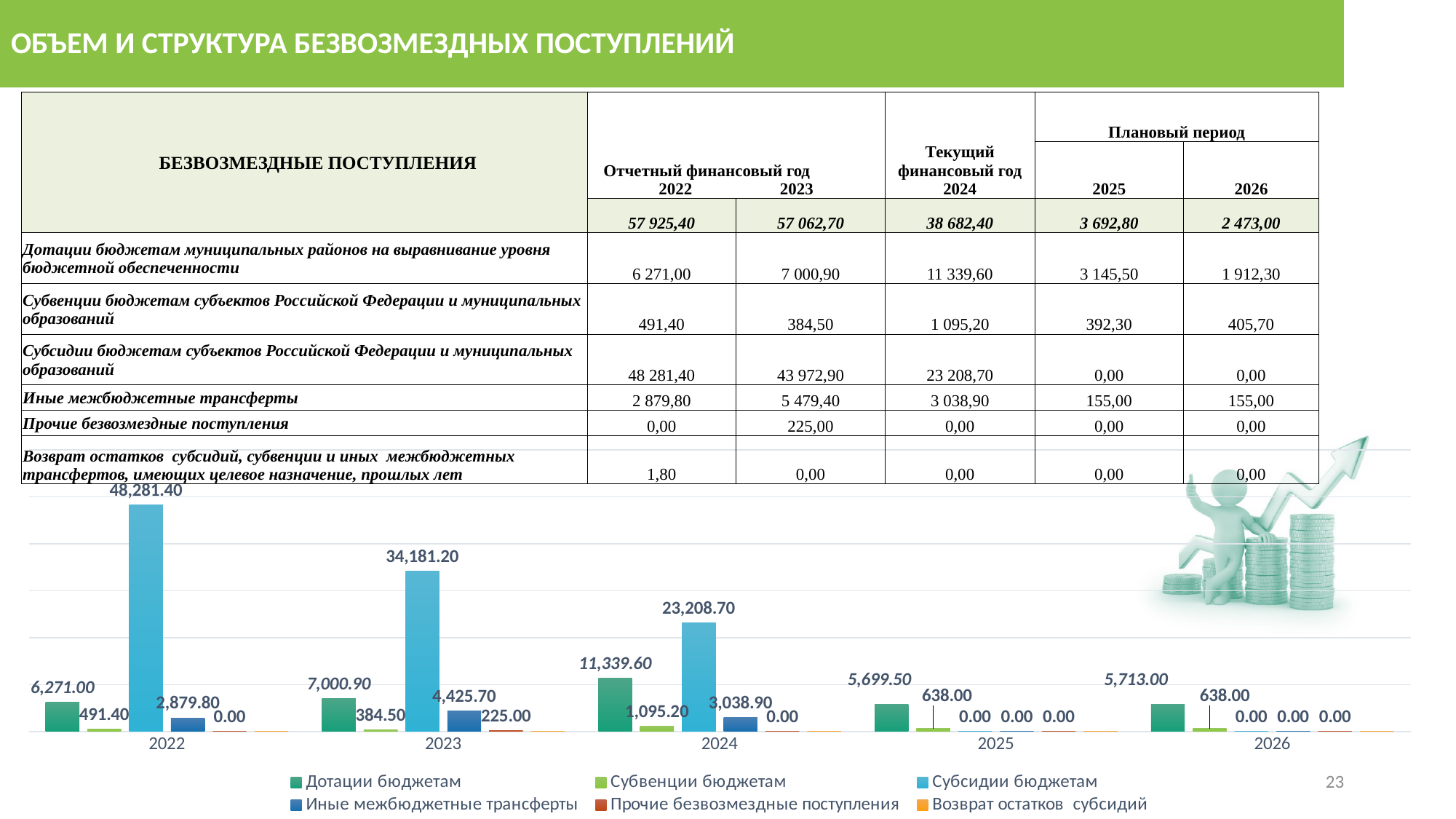
In the chart, what is the difference between the Субсидии бюджетам values for 2022 and 2023? 14,100.20 In the chart, what is the value of Субсидии бюджетам for 2022? 48,281.40 How many series does the chart legend list? 6 In the chart, what is the value of Иные межбюджетные трансферты for 2023? 4,425.70 In the chart, what is the value of Субвенции бюджетам for 2025? 638.00 In the chart, which is larger: Дотации бюджетам for 2025 or for 2026? 2026 In the chart, which year has the lowest value for Субвенции бюджетам? 2023 In the chart, does the value of Субсидии бюджетам rise or fall from 2022 to 2024? fall In the chart, which year has the highest value for Субсидии бюджетам? 2022 How many year categories are shown on the x axis of the chart? 5 In the chart, what is the value of Дотации бюджетам for 2024? 11,339.60 What kind of chart is shown at the bottom of the slide? bar chart